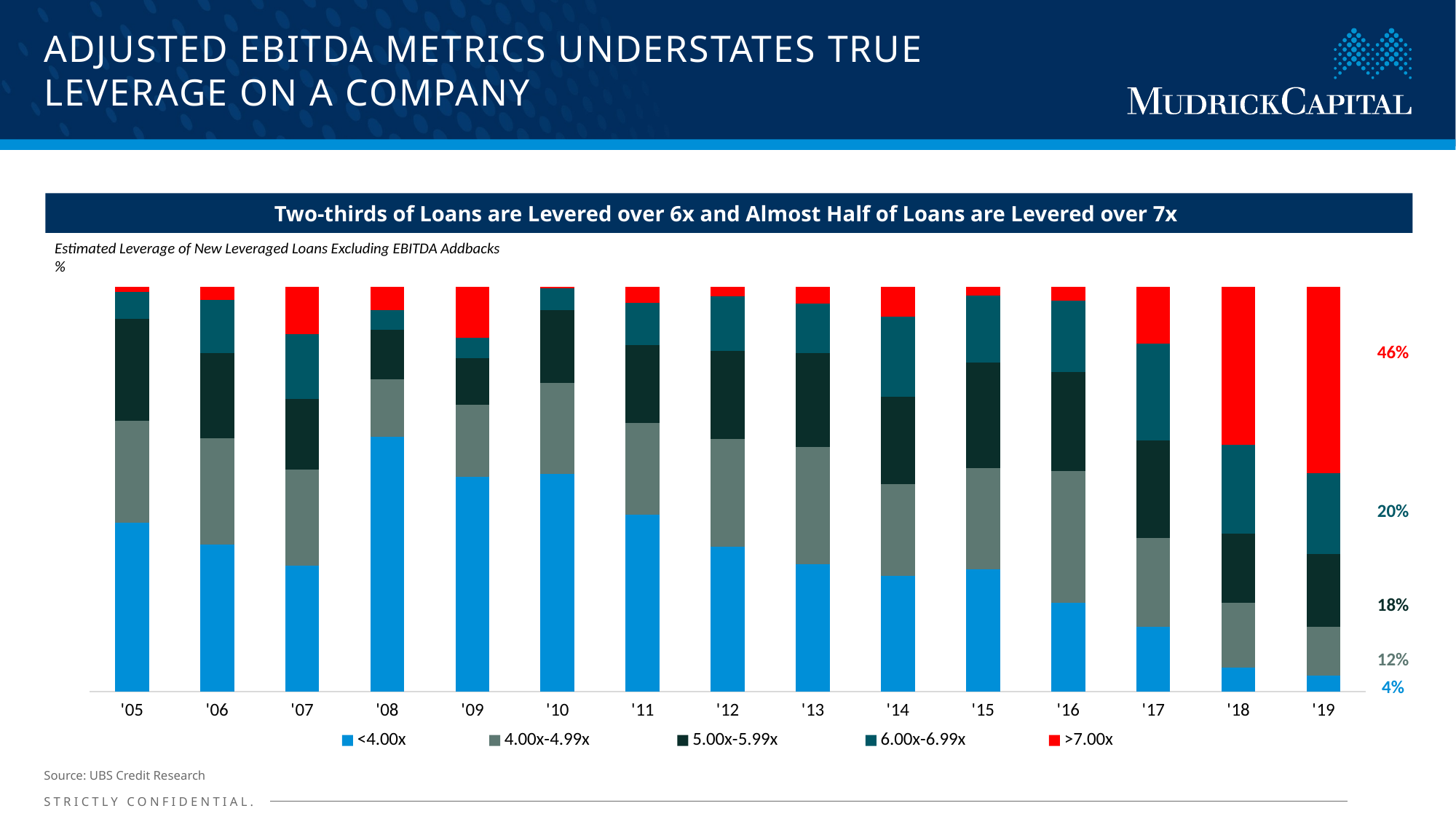
What is the share of loans levered <4.00x in '19? 4% In '19, which leverage bucket has the largest share? >7.00x In '19, which leverage bucket has the smallest share? <4.00x How many years are shown along the x axis of the chart? 15 What colour represents the >7.00x series in the chart? Red How many series does the chart's legend list? 5 What is the share of loans levered 5.00x-5.99x in '19? 18% What kind of chart is shown on the slide? Stacked bar chart What is the share of loans levered >7.00x in '19? 46% What is the difference between the >7.00x share and the 6.00x-6.99x share in '19? 26% What is the share of loans levered 6.00x-6.99x in '19? 20% Does the share of loans levered >7.00x rise or fall from '05 to '19? Rise